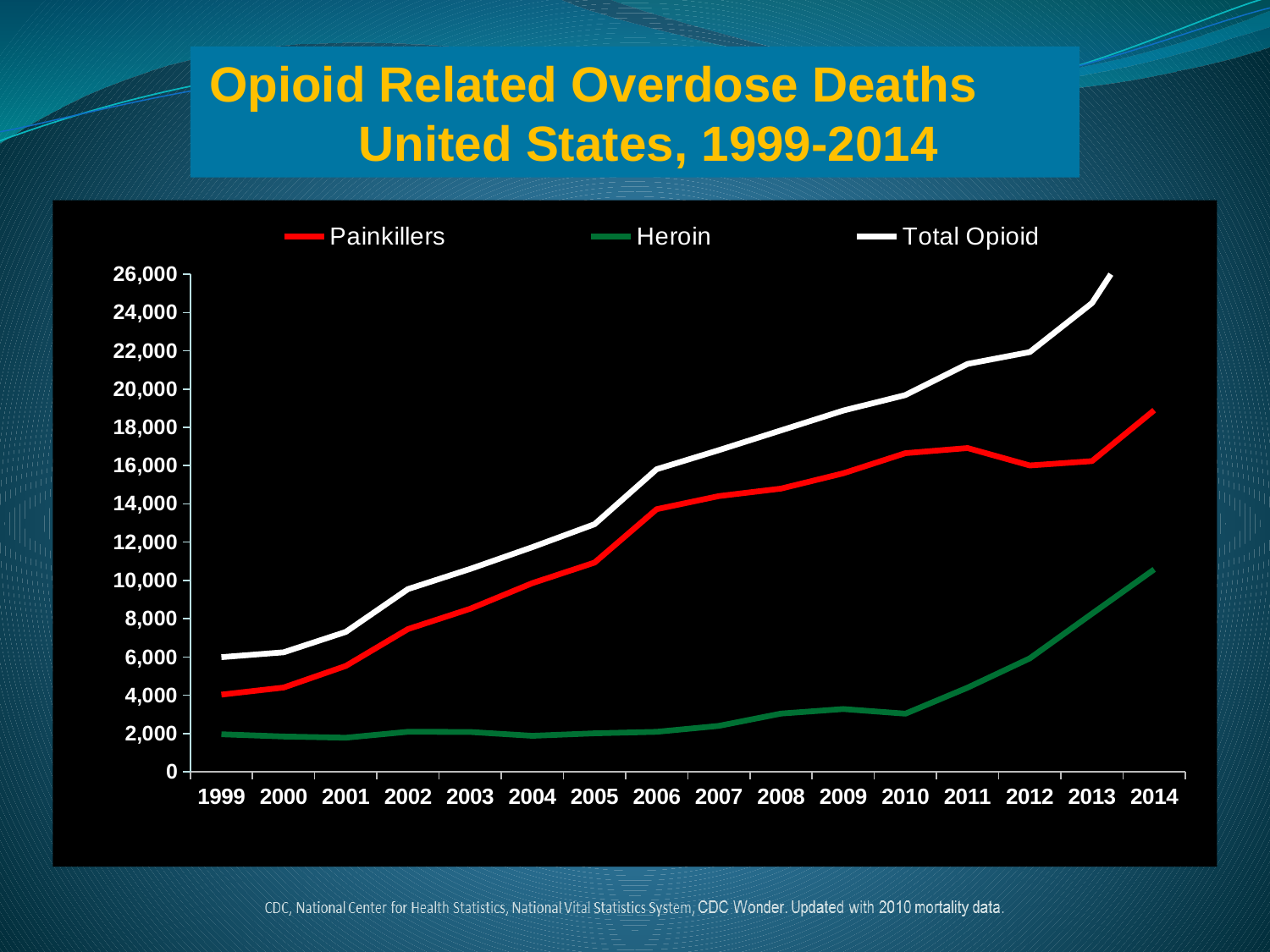
Which series is drawn in red? Painkillers Is the Painkillers value for 2014 greater or less than 18,000? greater What kind of chart is shown on the slide? Line chart Does the Heroin line generally rise or fall from 1999 to 2014? Rise How many series does the legend list? 3 Which series has the lowest value in 2014? Heroin Is the Total Opioid value for 2014 greater or less than 24,000? greater Which series has the highest value in 2014? Total Opioid How many years are plotted along the x axis? 16 Is the Heroin value for 2014 greater or less than 8,000? greater